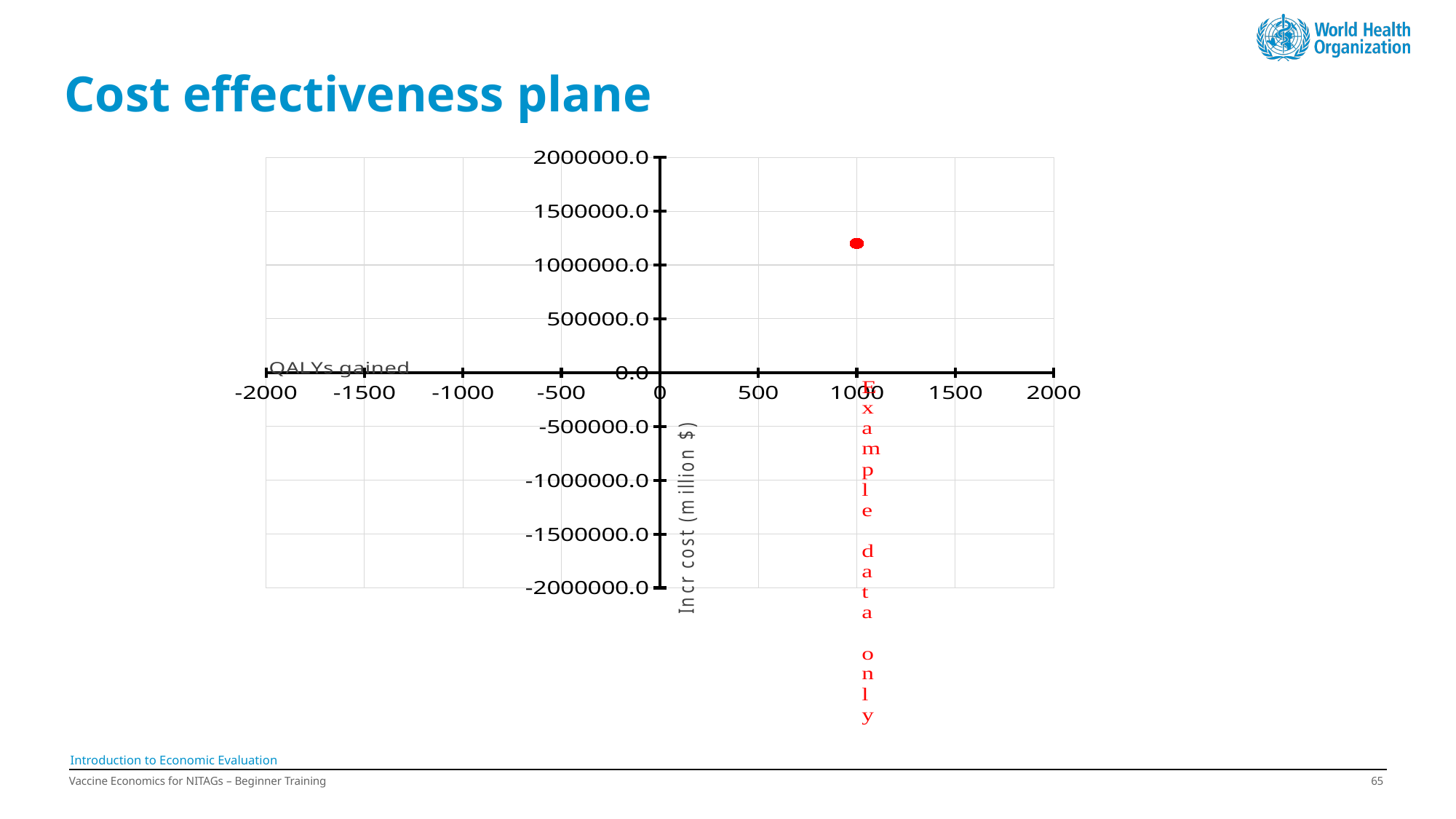
What is the label of the horizontal axis? QALYs gained What kind of chart is shown on the slide? scatter chart What is the highest value shown on the vertical axis? 2000000.0 Is the QALYs gained value of the plotted point greater or less than 500? greater Is the plotted point above or below the 0.0 line on the incremental cost axis? above What is the QALYs gained value of the plotted point, as read from the x-axis tick it lies on? 1000 Is the incremental cost value of the plotted point greater or less than 1500000.0? less How many data points are plotted on the chart? 1 What is the label of the vertical axis? Incr cost (million $)